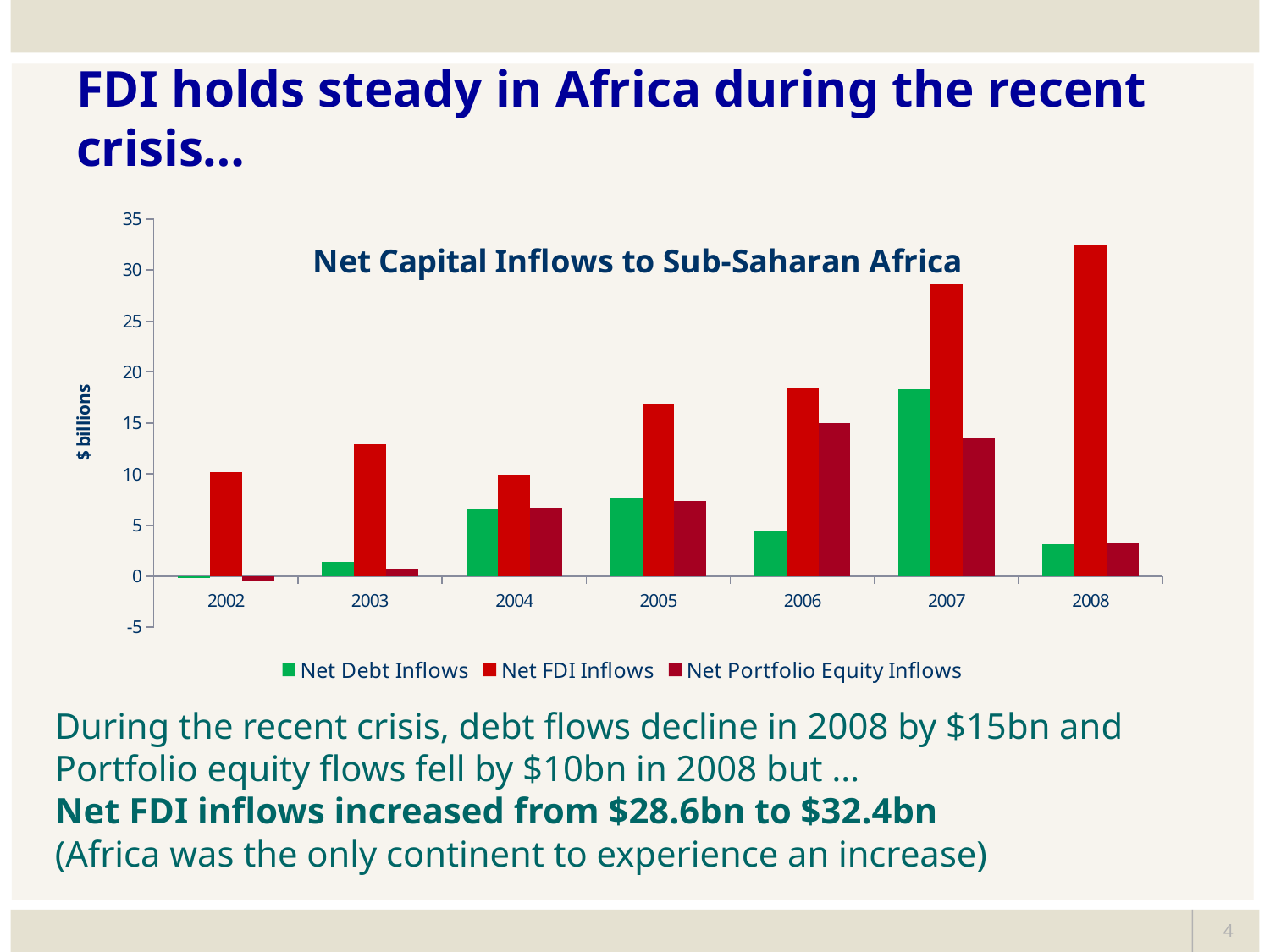
Is the value for Net Debt Inflows in 2008 greater or less than 5? less In 2006, which is larger: Net FDI Inflows or Net Portfolio Equity Inflows? Net FDI Inflows In which year are Net Debt Inflows highest? 2007 According to the slide, what were Net FDI inflows in 2008? $32.4bn What is the label on the vertical axis of the chart? $ billions How many years are shown on the x axis of the chart? 7 In which year are Net FDI Inflows highest? 2008 Is the value for Net Portfolio Equity Inflows in 2007 greater or less than 10? greater What type of chart is shown on the slide? Bar chart Is the value for Net FDI Inflows in 2008 greater or less than 30? greater What is the title of the chart? Net Capital Inflows to Sub-Saharan Africa How many series does the chart legend list? 3